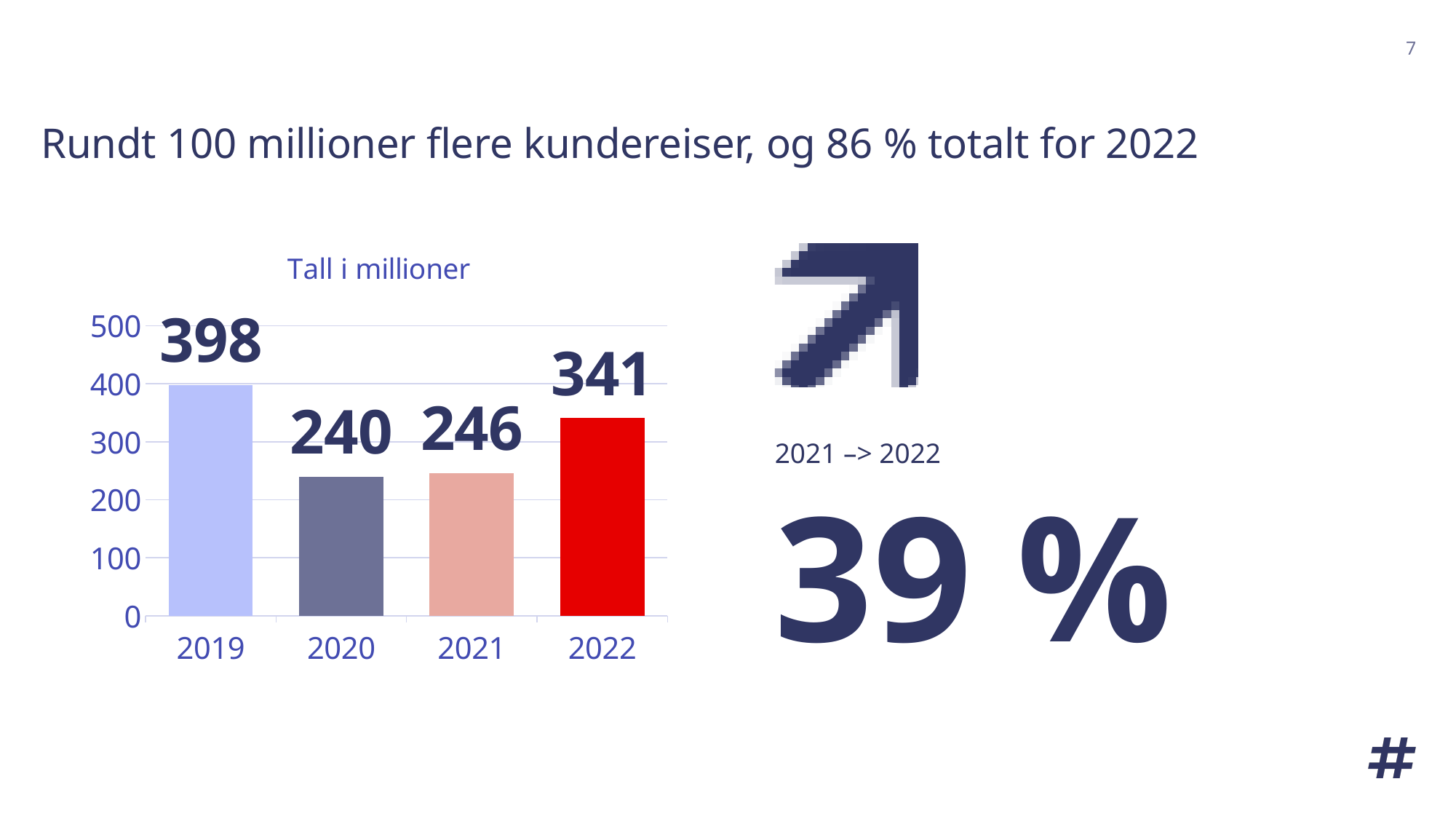
Which year has the highest value? 2019 What is the value for 2020? 240 What is the title of the chart? Tall i millioner How many years are shown on the x axis? 4 What kind of chart is shown? bar chart What is the value for 2022? 341 Which is larger, the value for 2019 or the value for 2022? 2019 What is the value for 2019? 398 What is the difference between the values for 2019 and 2022? 57 What is the difference between the values for 2022 and 2021? 95 Which year has the lowest value? 2020 Is the value for 2021 greater or less than 300? less